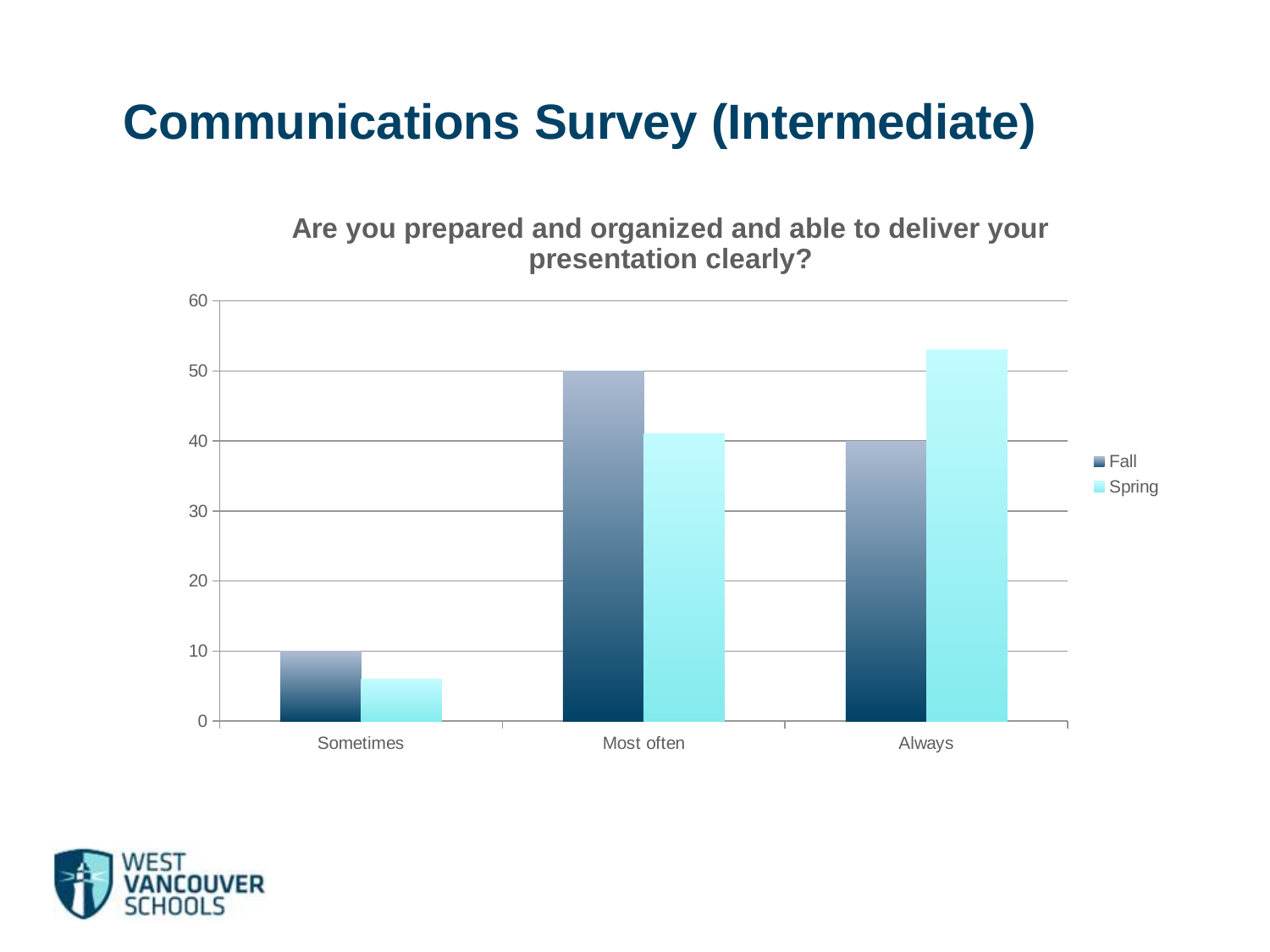
What is the Fall value for "Most often"? 50 What is the Fall value for "Sometimes"? 10 What is the difference between the Fall values for "Most often" and "Always"? 10 How many series does the legend list? 2 How many categories are shown on the x axis? 3 What is the title of the chart? Are you prepared and organized and able to deliver your presentation clearly? For "Always", which series has the larger value, Fall or Spring? Spring Is the Spring value for "Most often" greater or less than 50? less What kind of chart is shown on the slide? bar chart Which category has the highest Fall value? Most often Which category has the lowest Spring value? Sometimes What is the Fall value for "Always"? 40